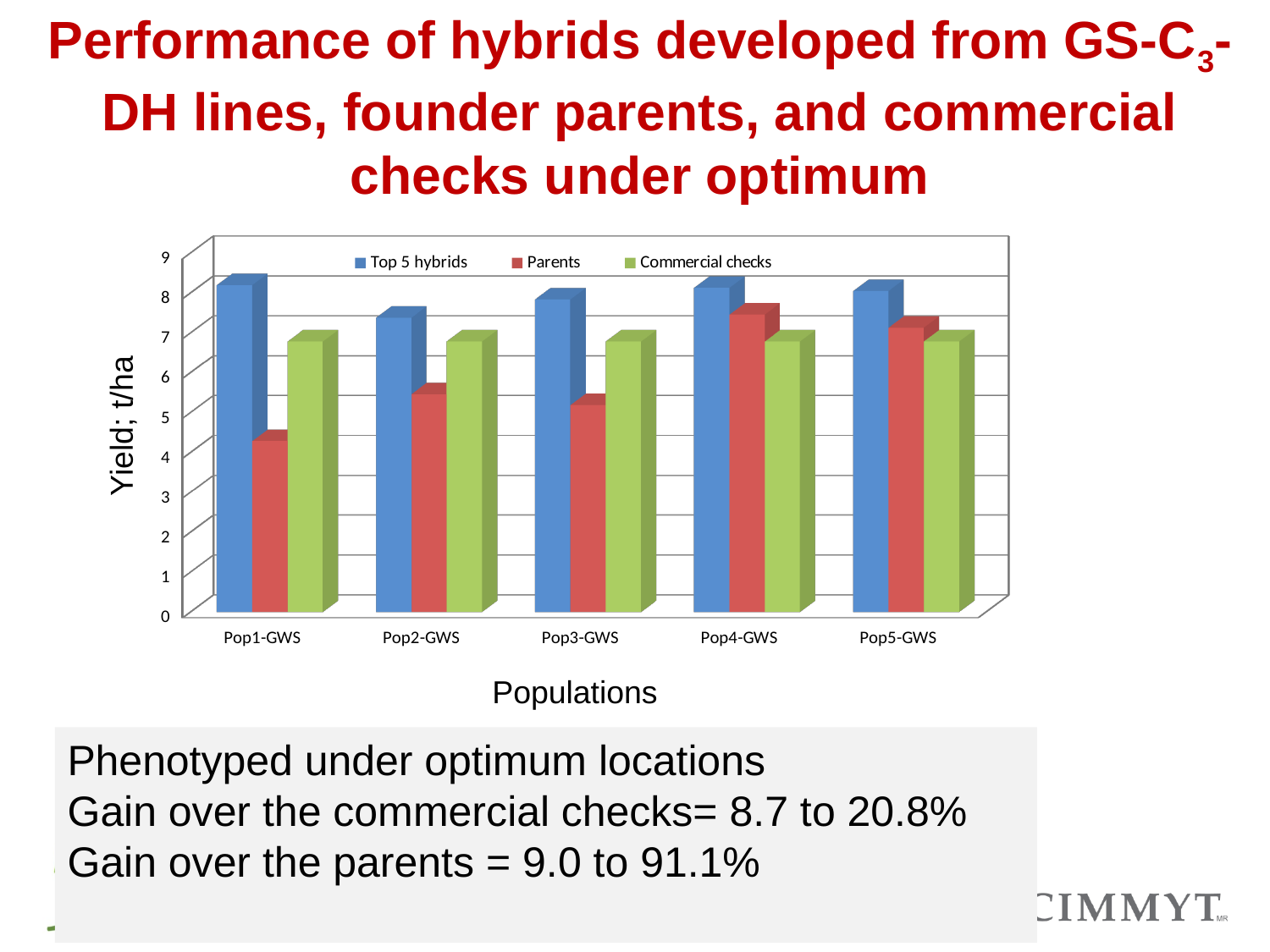
How many series does the chart legend list? 3 For Pop4-GWS, which is larger: the Parents value or the Commercial checks value? Parents Is the Top 5 hybrids value for Pop1-GWS greater or less than 8? greater Is the Top 5 hybrids value for Pop2-GWS greater or less than 8? less For which population is the Parents value lowest? Pop1-GWS Is the Parents value for Pop4-GWS greater or less than 7? greater What is the label of the y axis of the chart? Yield; t/ha How many populations are shown on the x axis of the chart? 5 What kind of chart is shown on the slide? bar chart For which population is the Top 5 hybrids value lowest? Pop2-GWS